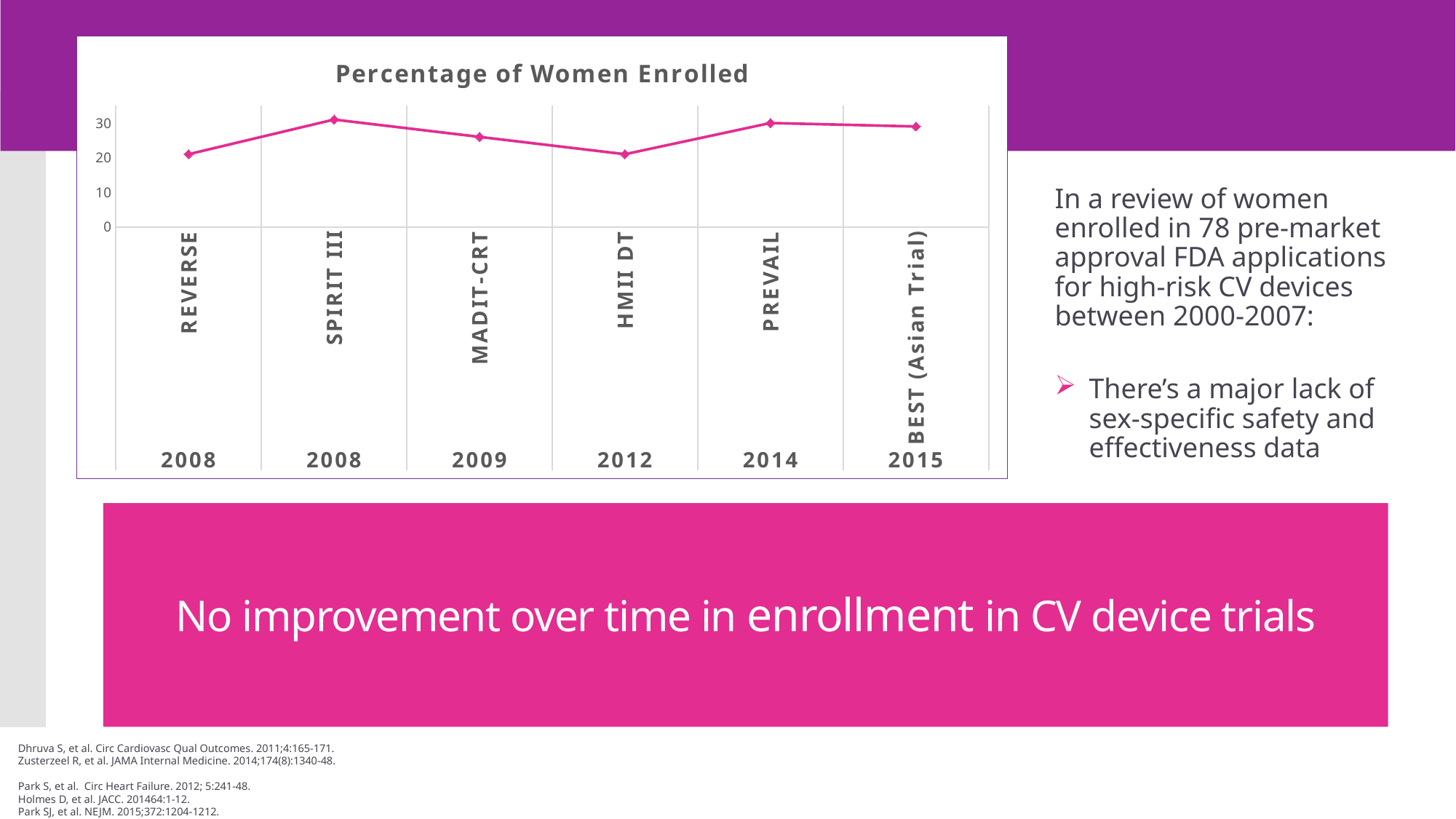
Which has a higher percentage of women enrolled, SPIRIT III or MADIT-CRT? SPIRIT III Which has a higher percentage of women enrolled, MADIT-CRT or HMII DT? MADIT-CRT Is the value for MADIT-CRT greater or less than 20? greater What is the title of the chart? Percentage of Women Enrolled Is the value for SPIRIT III greater or less than 20? greater Is the value for MADIT-CRT greater or less than 30? less Does the percentage of women enrolled rise or fall from SPIRIT III to HMII DT? Fall Which year is shown under the BEST (Asian Trial) category? 2015 How many trials are plotted on the chart? 6 What kind of chart is shown on the slide? Line chart Which has a higher percentage of women enrolled, REVERSE or SPIRIT III? SPIRIT III